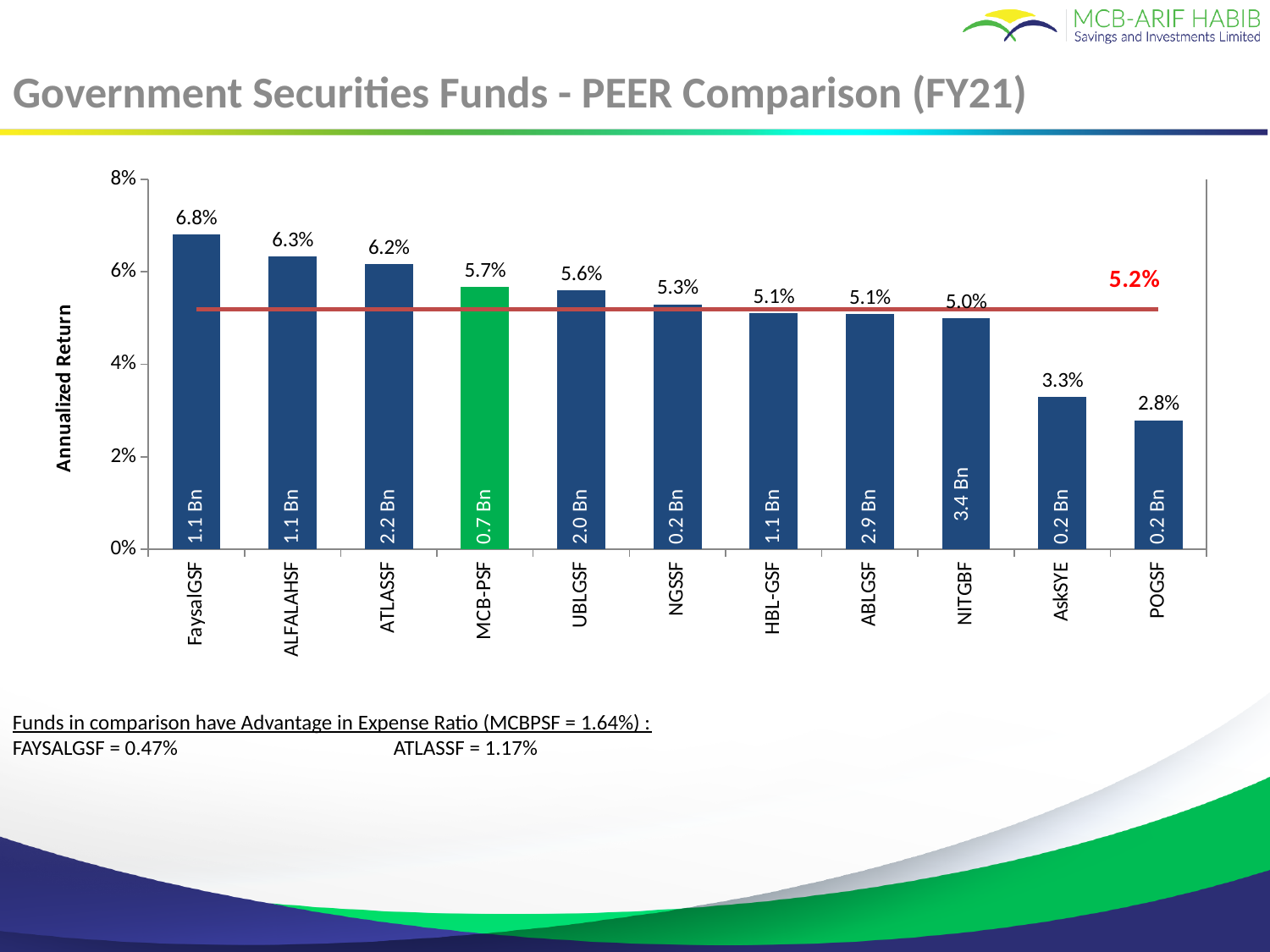
What is the difference in annualized return between FaysalGSF and MCB-PSF? 1.1% What is the annualized return for POGSF? 2.8% Which fund has the highest annualized return? FaysalGSF What fund size is labelled inside the NITGBF bar? 3.4 Bn What value does the red horizontal line in the chart represent? 5.2% Which fund has the lowest annualized return? POGSF Which fund has a higher annualized return, ATLASSF or UBLGSF? ATLASSF Is the annualized return for AskSYE greater or less than 4%? less How many funds are shown in the chart? 11 What is the annualized return for FaysalGSF? 6.8% What type of chart is shown on the slide? Bar chart What is the annualized return for MCB-PSF? 5.7%